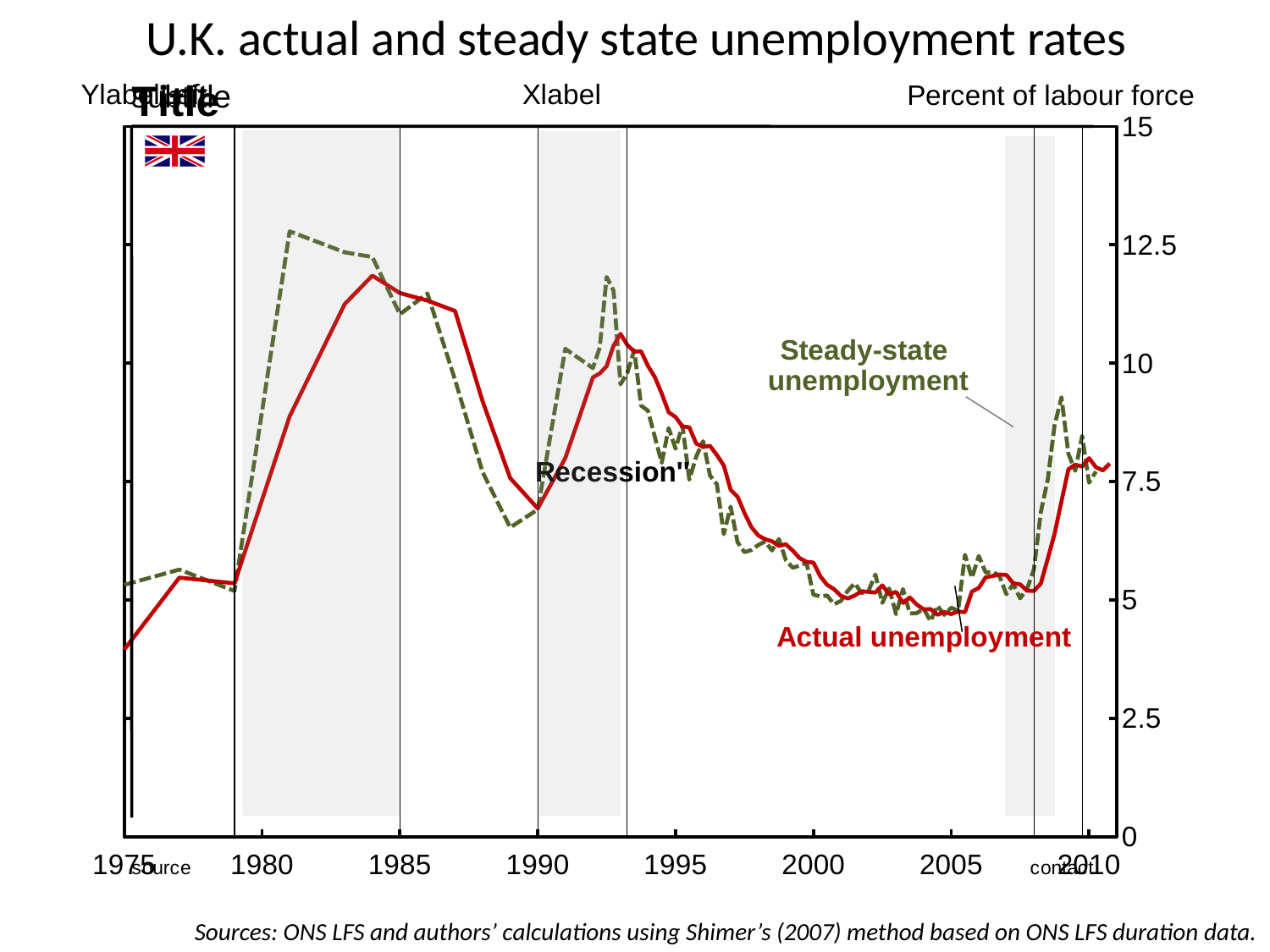
In 1981, which series is higher: actual unemployment or steady-state unemployment? Steady-state unemployment What kind of chart is shown on the slide? line chart Does actual unemployment rise or fall between 1993 and 2004? fall Is the value of actual unemployment in 1984 greater or less than 10? greater Is the value of actual unemployment in 2005 greater or less than 7.5? less In 1989, which series is higher: actual unemployment or steady-state unemployment? Actual unemployment What is the title of the chart? U.K. actual and steady state unemployment rates How many data series are plotted on the chart? 2 Is the value of steady-state unemployment in 1981 greater or less than 10? greater In which year does actual unemployment reach its highest point? 1984 What unit is given for the vertical axis? Percent of labour force